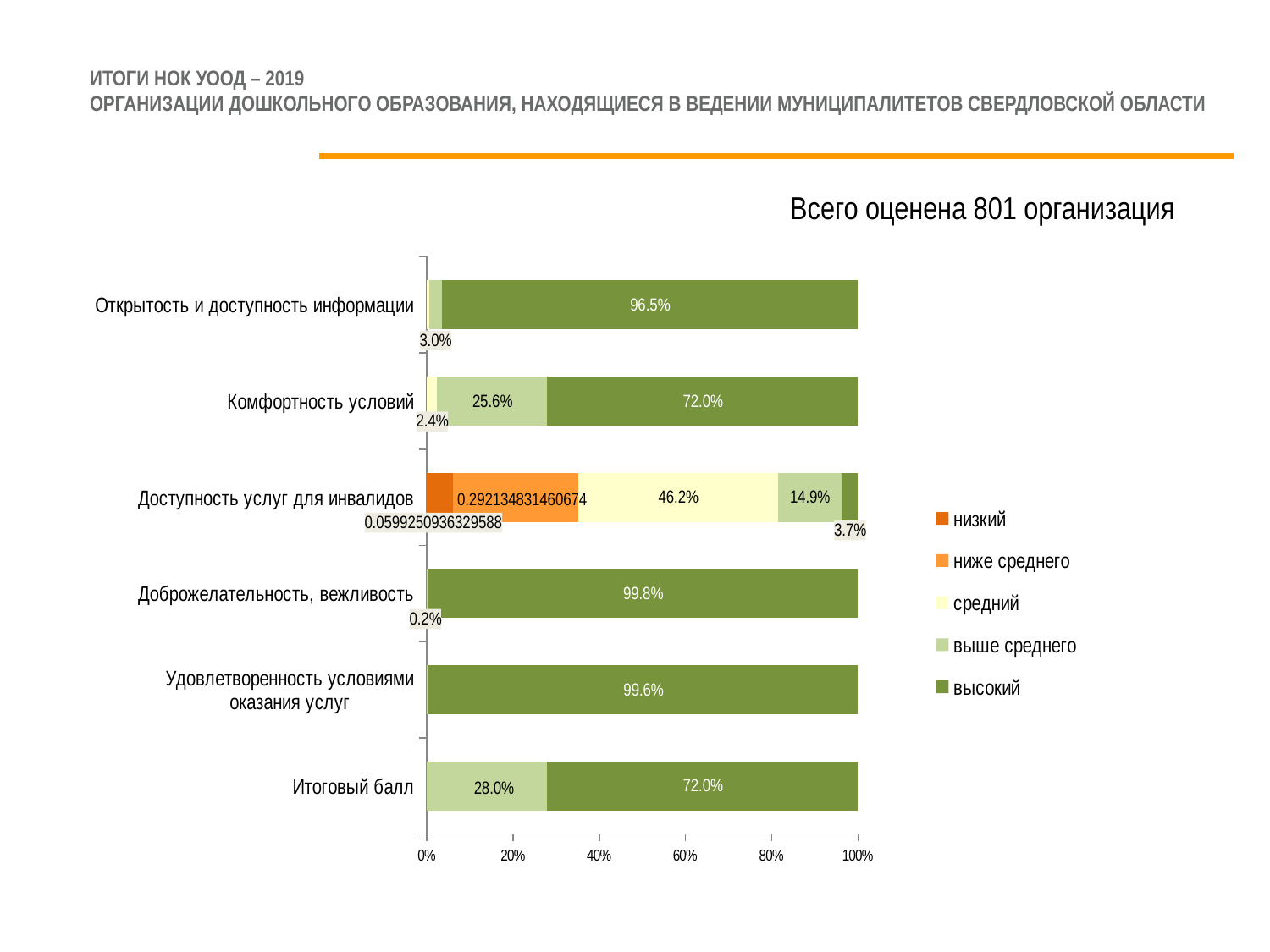
What is the value of the 'высокий' segment for 'Доброжелательность, вежливость'? 99.8% What is the value of the 'средний' segment for 'Доступность услуг для инвалидов'? 46.2% What is the value of the 'выше среднего' segment for 'Комфортность условий'? 25.6% How many categories are plotted on the chart? 6 What is the value of the 'выше среднего' segment for 'Итоговый балл'? 28.0% What is the value of the 'высокий' segment for 'Открытость и доступность информации'? 96.5% How many series does the legend list? 5 Which category has the lowest 'высокий' value? Доступность услуг для инвалидов What kind of chart is shown on the slide? stacked bar chart According to the text above the chart, how many organisations were evaluated in total? 801 Which category has the highest 'высокий' value? Доброжелательность, вежливость What is the difference between the 'высокий' values for 'Доброжелательность, вежливость' and 'Удовлетворенность условиями оказания услуг'? 0.2%